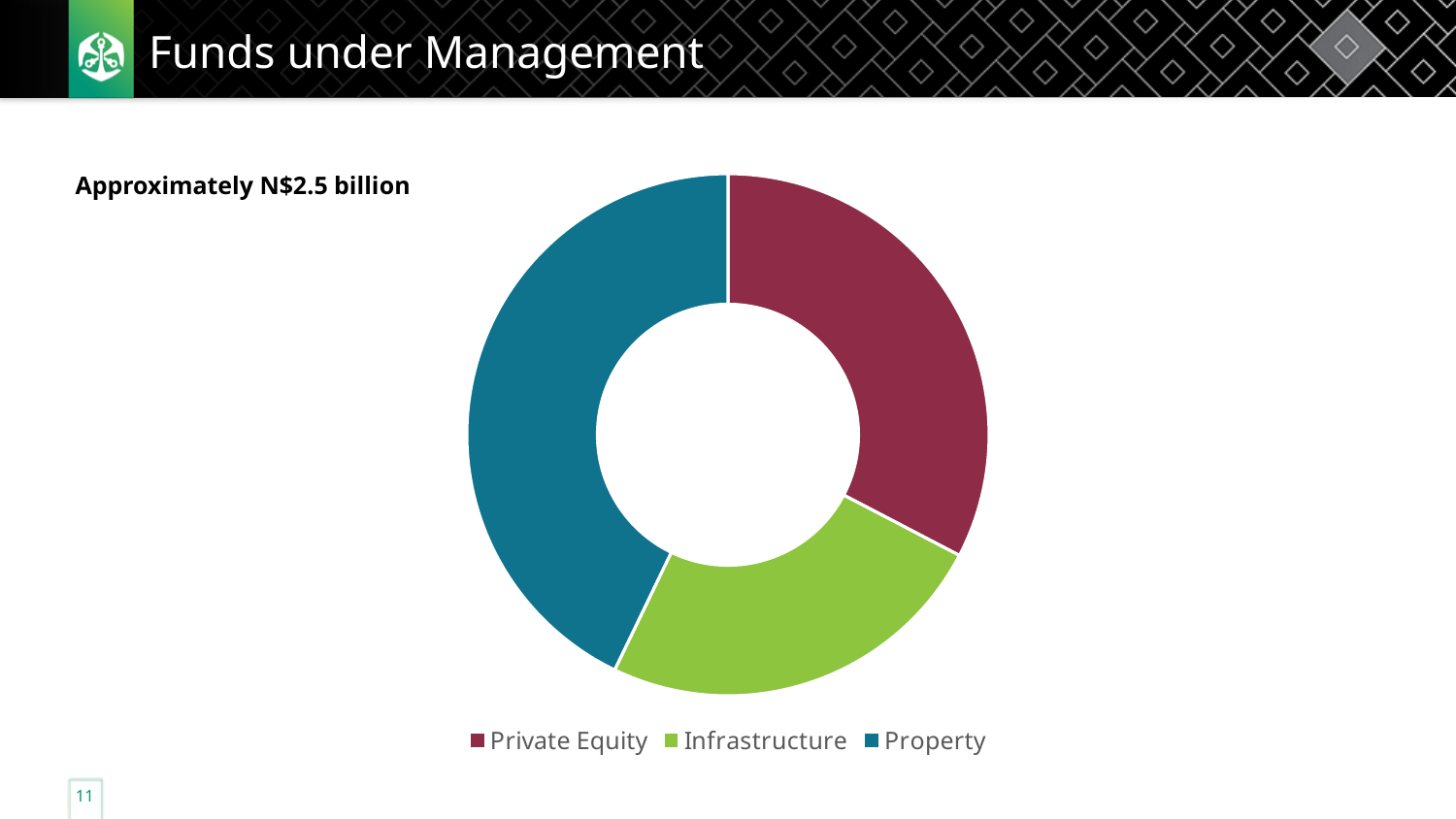
What are the three categories listed in the chart legend? Private Equity, Infrastructure, Property Which category has the smallest slice of the chart? Infrastructure What kind of chart is shown on the slide? Pie chart (doughnut) What colour is the Infrastructure slice in the chart? Green Which slice is larger, Property or Infrastructure? Property How many categories does the chart show? 3 What is the title of the slide containing the chart? Funds under Management Which category has the largest slice of the chart? Property How many entries does the legend list? 3